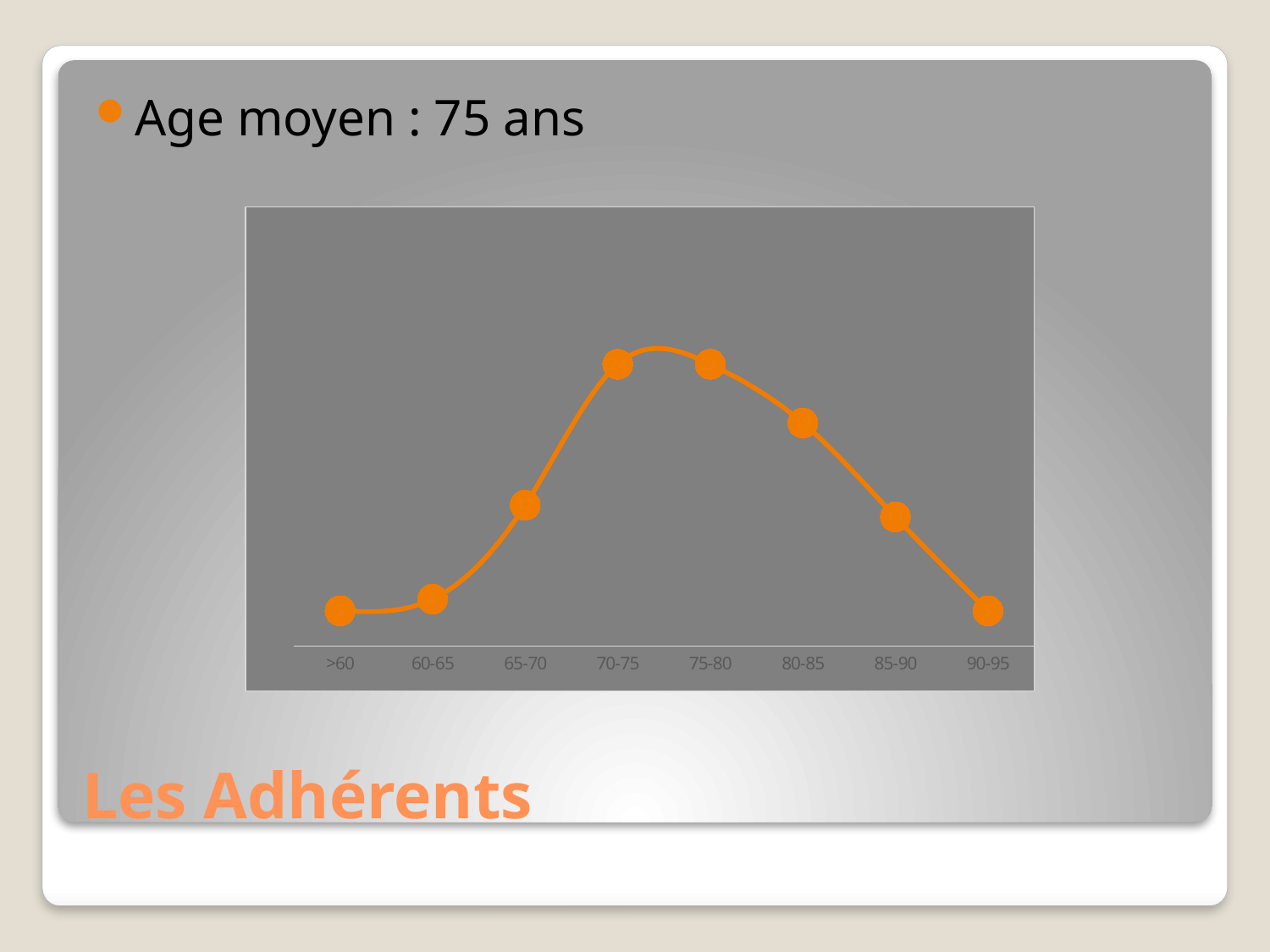
How many age categories are plotted along the x axis? 8 Which is lower, the value for 60-65 or the value for 75-80? 60-65 Which is higher, the value for 80-85 or the value for 90-95? 80-85 What colour is the plotted line? orange Which is higher, the value for 65-70 or the value for 80-85? 80-85 What is the first category label on the x axis? >60 Do the values rise or fall from >60 to 70-75? rise Do the values rise or fall from 75-80 to 90-95? fall What kind of chart is shown on the slide? line chart